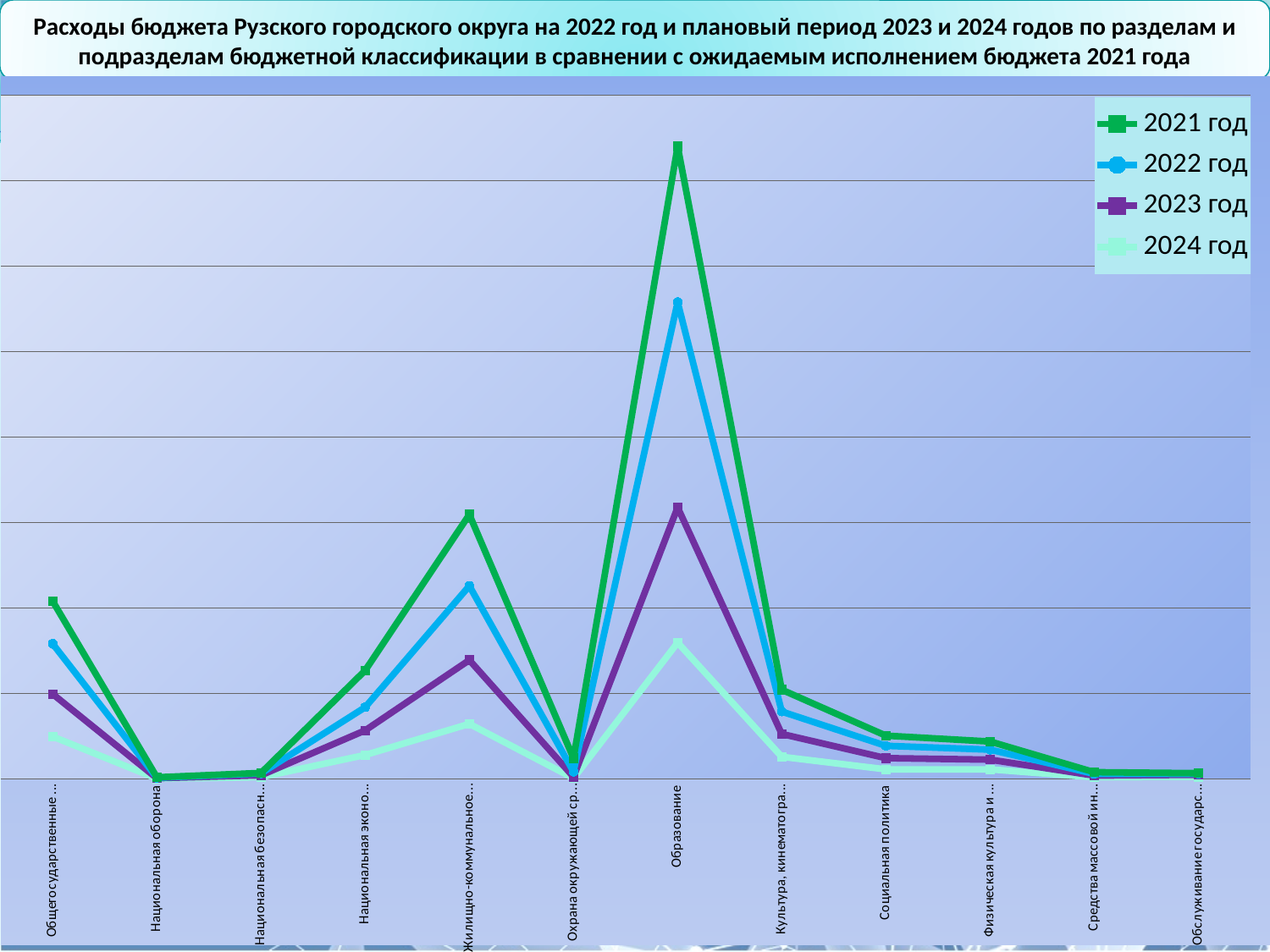
How many series does the legend list? 4 Which category has the highest value for the 2022 год series? Образование How many categories are plotted along the x axis? 12 Which category has the highest value for the 2024 год series? Образование For the category Образование, which series has the larger value: 2021 год or 2024 год? 2021 год For the category Образование, which series has the larger value: 2022 год or 2023 год? 2022 год Which series is listed last in the legend? 2024 год What kind of chart is shown on the slide? line chart Which series is shown in green in the legend? 2021 год Which category has the highest value for the 2021 год series? Образование For the category Социальная политика, which series has the larger value: 2021 год or 2024 год? 2021 год